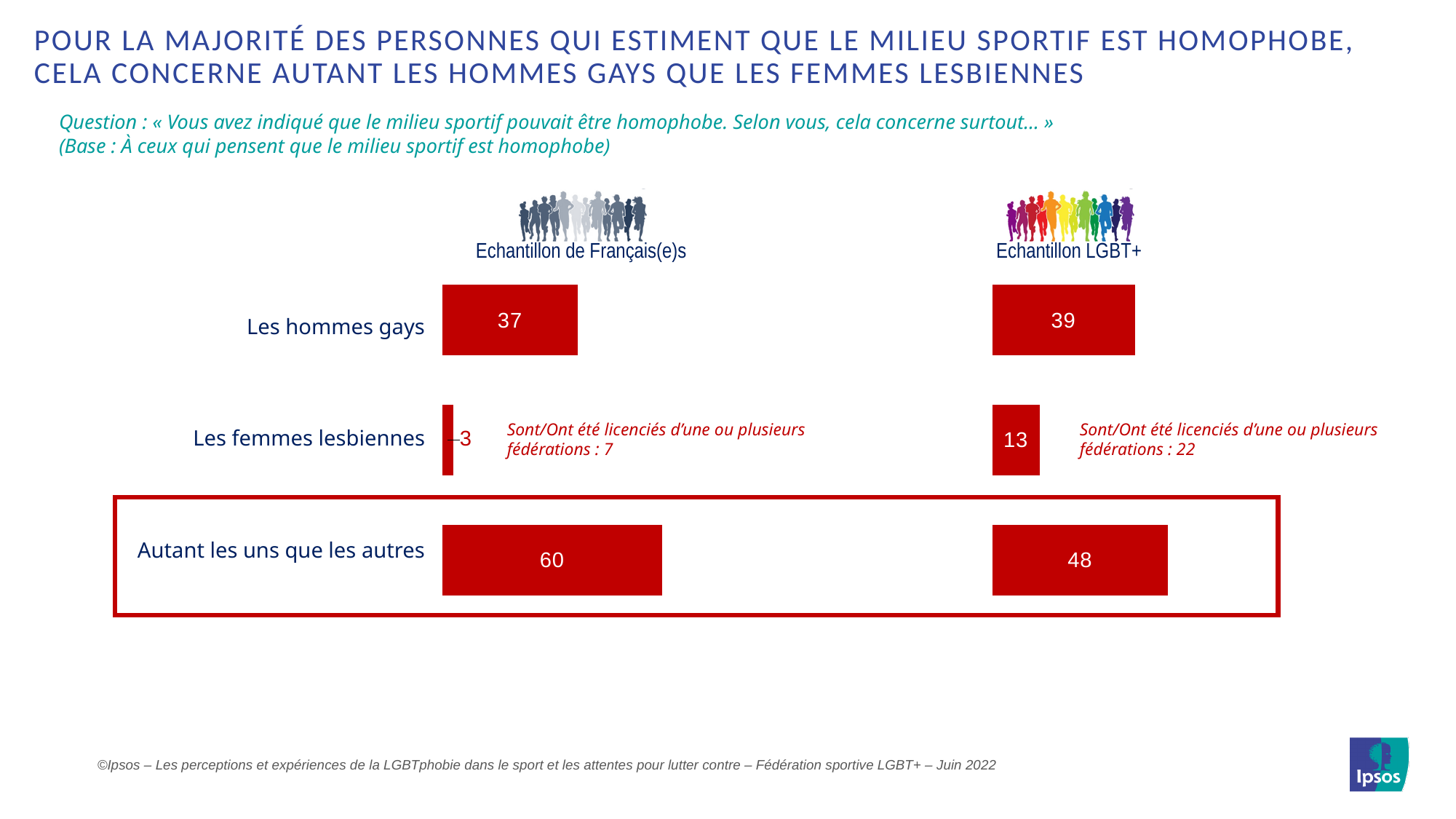
In the Echantillon LGBT+ chart, which category has the lowest value? Les femmes lesbiennes In the Echantillon LGBT+ chart, what is the value for Les femmes lesbiennes? 13 How many categories are shown in the Echantillon LGBT+ chart? 3 What colour are the bars in the two charts? Red Which is larger: the value for Les femmes lesbiennes in the Echantillon LGBT+ chart or in the Echantillon de Français(e)s chart? Echantillon LGBT+ In the Echantillon de Français(e)s chart, what is the difference between Autant les uns que les autres and Les hommes gays? 23 In the Echantillon de Français(e)s chart, what is the value for Les hommes gays? 37 In the Echantillon de Français(e)s chart, which category has the highest value? Autant les uns que les autres What is the difference between the Autant les uns que les autres values in the Echantillon de Français(e)s chart and the Echantillon LGBT+ chart? 12 What type of chart is the Echantillon de Français(e)s chart? Bar chart In the Echantillon de Français(e)s chart, what is the value for Les femmes lesbiennes? 3 In the Echantillon LGBT+ chart, what is the value for Autant les uns que les autres? 48